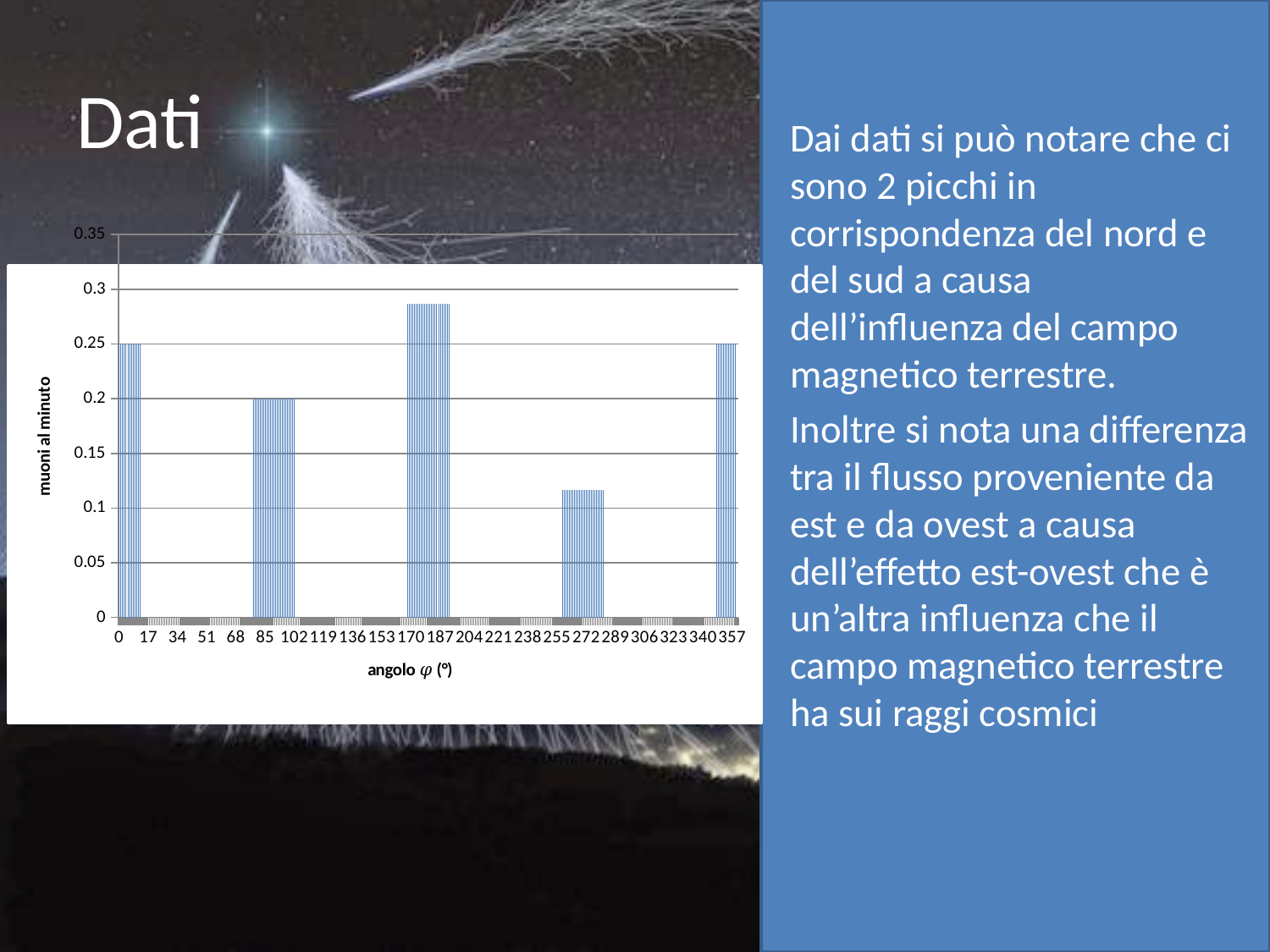
Is the value of the bar near 180° greater or less than 0.25? greater What is the difference between the bar at 0° and the bar near 90°? 0.05 What is the value of the bar at angle 0°? 0.25 Which bar is the highest in the chart? the bar near 180° (between the 170 and 187 ticks) Which of the visible bars is the lowest? the bar near 270° (between the 255 and 272 ticks) Is the value of the bar near 270° greater or less than 0.15? less What is the title of the x axis of the chart? angolo φ (°) What is the value of the bar at angle 357°? 0.25 What is the value of the bar located near 90° (between the 85 and 102 ticks)? 0.2 What kind of chart is shown on the slide? bar chart What is the title of the y axis of the chart? muoni al minuto How many visible bars (non-zero values) does the chart show? 5